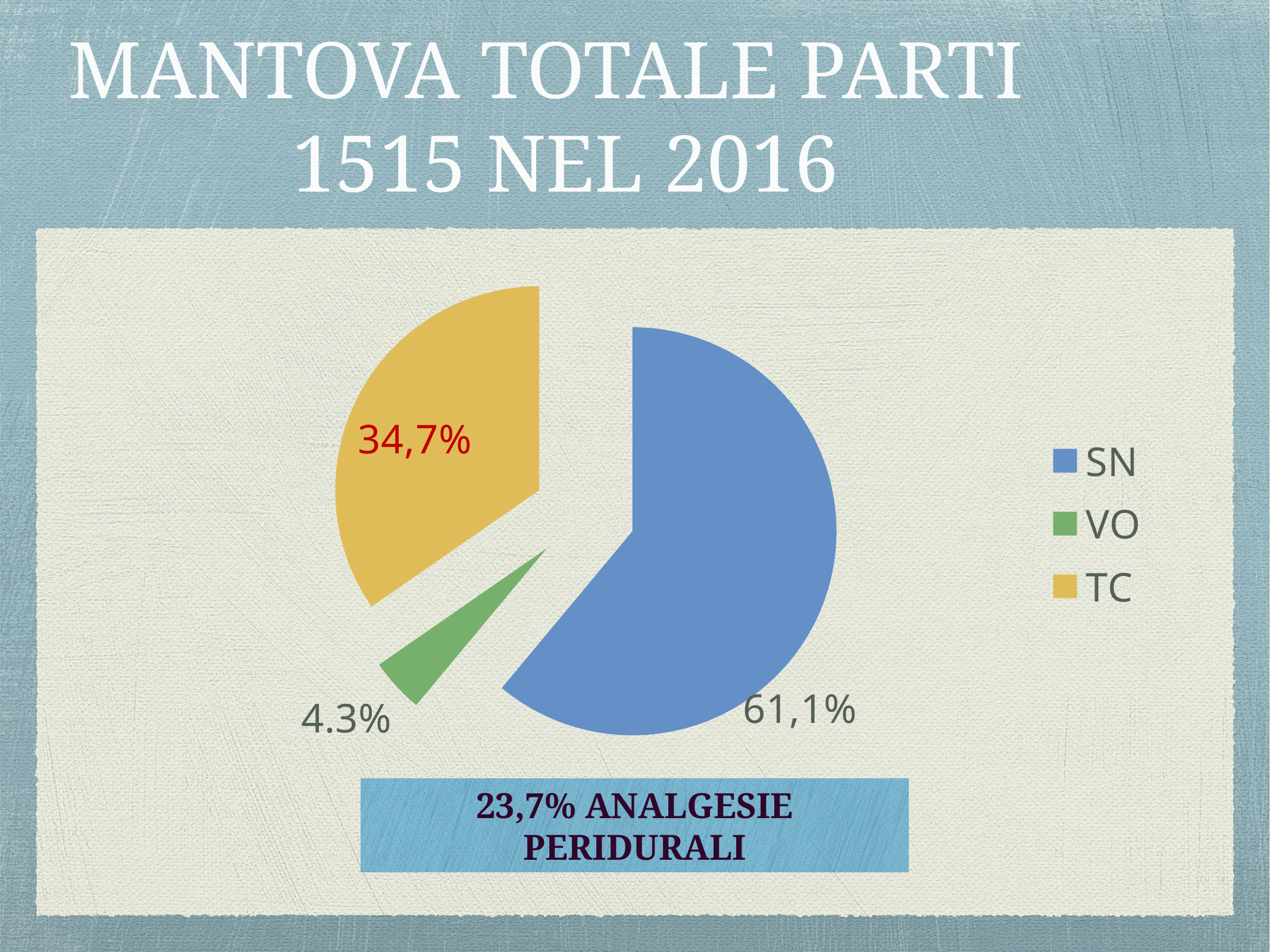
What kind of chart is shown on the slide? pie chart Which category has the largest slice of the pie? SN Which colour represents TC in the pie chart? yellow What percentage is shown for the VO slice? 4.3% Which slice is larger, TC or VO? TC What percentage is shown for the SN slice? 61,1% Which category has the smallest slice of the pie? VO How many slices does the pie chart have? 3 How many entries does the legend list? 3 What is the difference in percentage points between the SN slice and the TC slice? 26,4 What total number of births (parti) is stated in the slide title for 2016? 1515 What percentage is shown for the TC slice? 34,7%